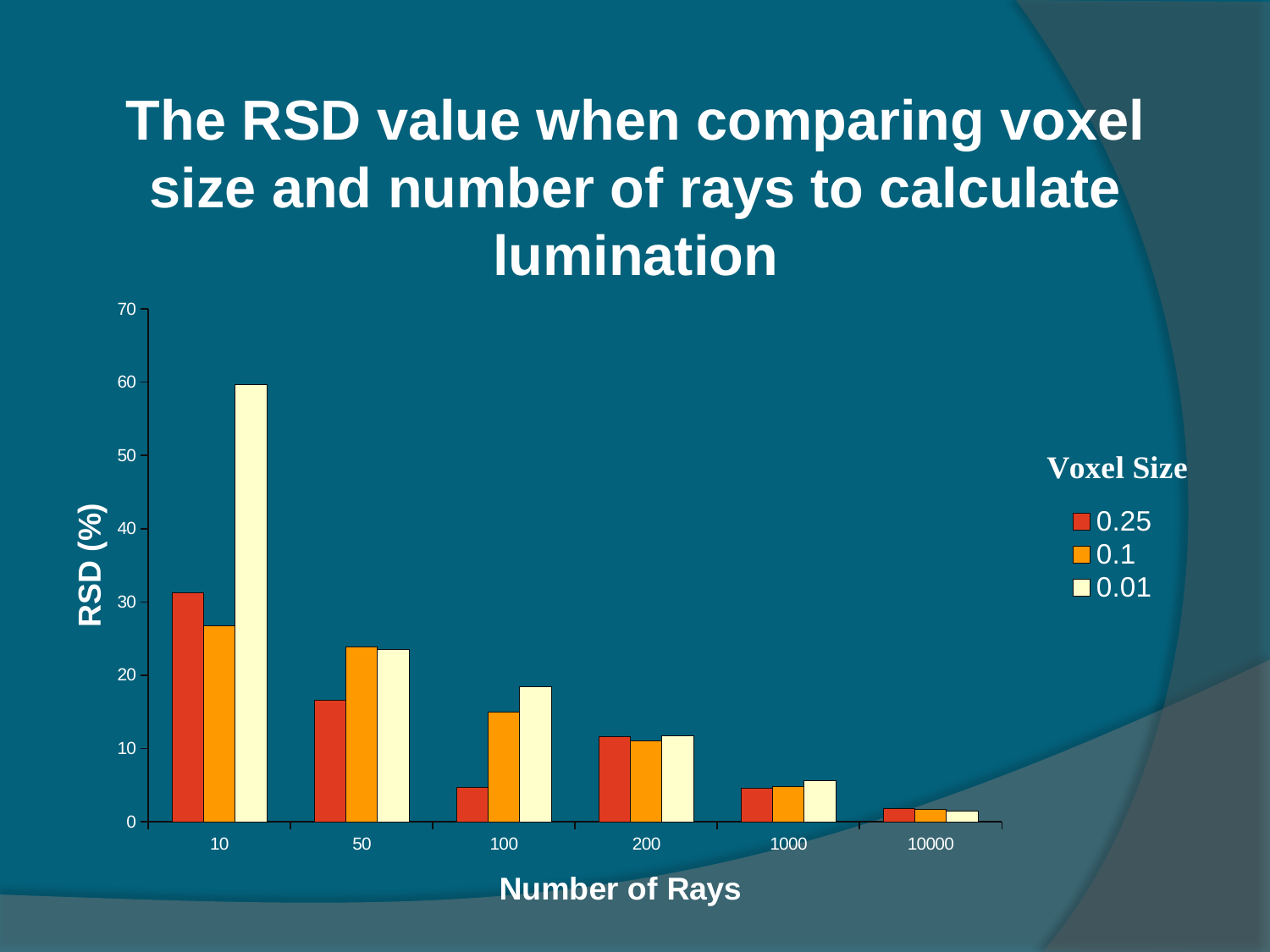
Is the RSD value for voxel size 0.01 at 10 rays greater or less than 50? greater How many Number of Rays categories are shown on the x axis? 6 Is the RSD value for voxel size 0.1 at 100 rays greater or less than 10? greater For the 0.01 voxel size series, which number of rays has the lowest RSD? 10000 What kind of chart is shown on the slide? bar chart How many series does the legend list? 3 What is the title of the legend? Voxel Size Is the RSD value for voxel size 0.25 at 10 rays greater or less than 20? greater At 100 rays, which voxel size has the larger RSD, 0.25 or 0.01? 0.01 Does the RSD for voxel size 0.01 rise or fall as the number of rays increases along the x axis? fall At 10 rays, which voxel size has the larger RSD, 0.25 or 0.1? 0.25 For the 0.01 voxel size series, which number of rays has the highest RSD? 10